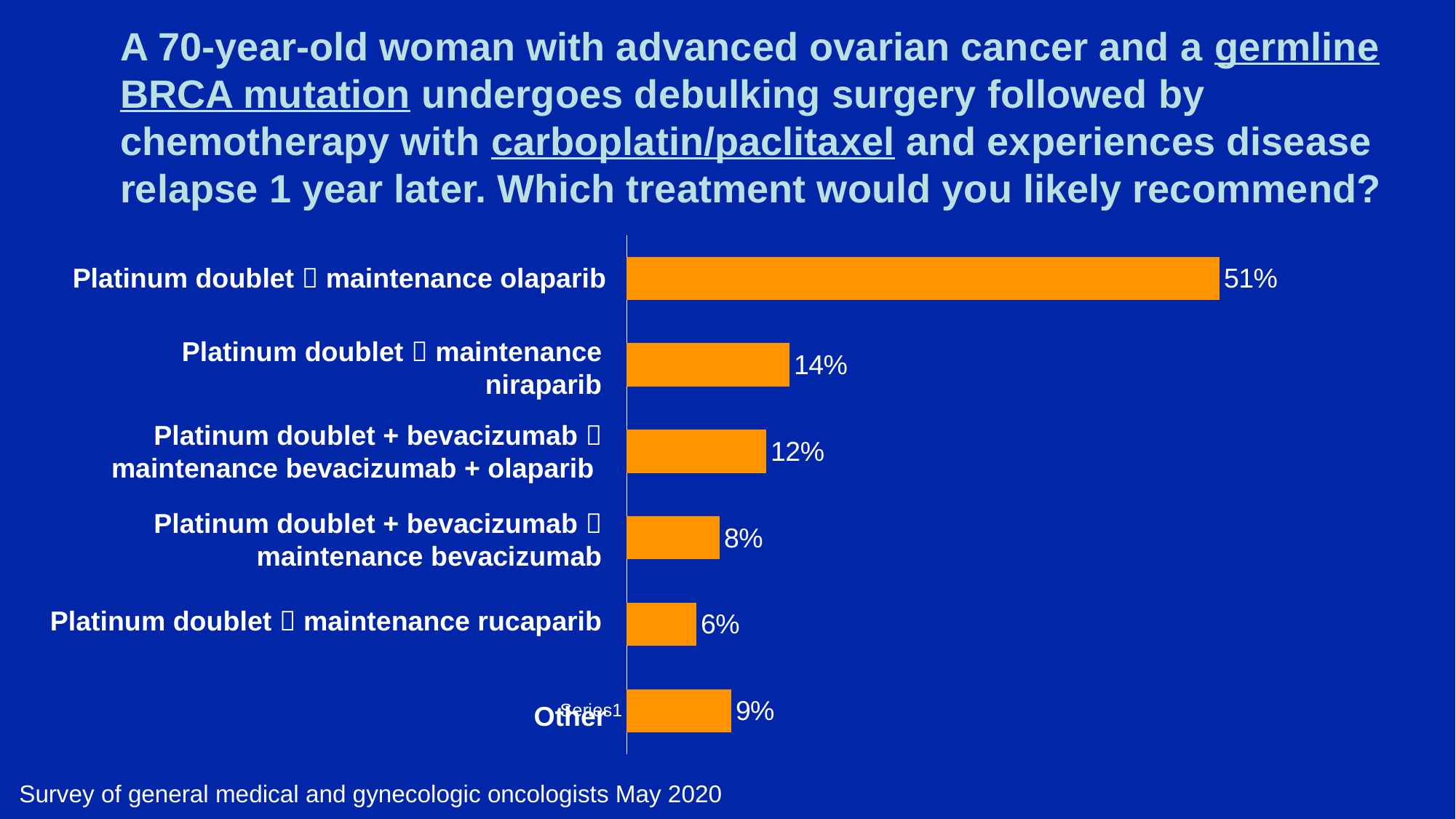
Which treatment option received the lowest percentage of responses? Platinum doublet → maintenance rucaparib What percentage of respondents chose Platinum doublet → maintenance olaparib? 51% What percentage of respondents chose Platinum doublet → maintenance niraparib? 14% What colour are the bars in the chart? Orange What percentage of respondents chose Platinum doublet + bevacizumab → maintenance bevacizumab + olaparib? 12% Which received a larger share of responses: Platinum doublet + bevacizumab → maintenance bevacizumab or Other? Other What percentage of respondents chose Other? 9% What percentage of respondents chose Platinum doublet → maintenance rucaparib? 6% What type of chart is shown on the slide? Bar chart What is the difference in percentage points between Platinum doublet → maintenance olaparib and Platinum doublet → maintenance niraparib? 37 Which treatment option received the highest percentage of responses? Platinum doublet → maintenance olaparib How many treatment options (categories) are shown in the chart? 6